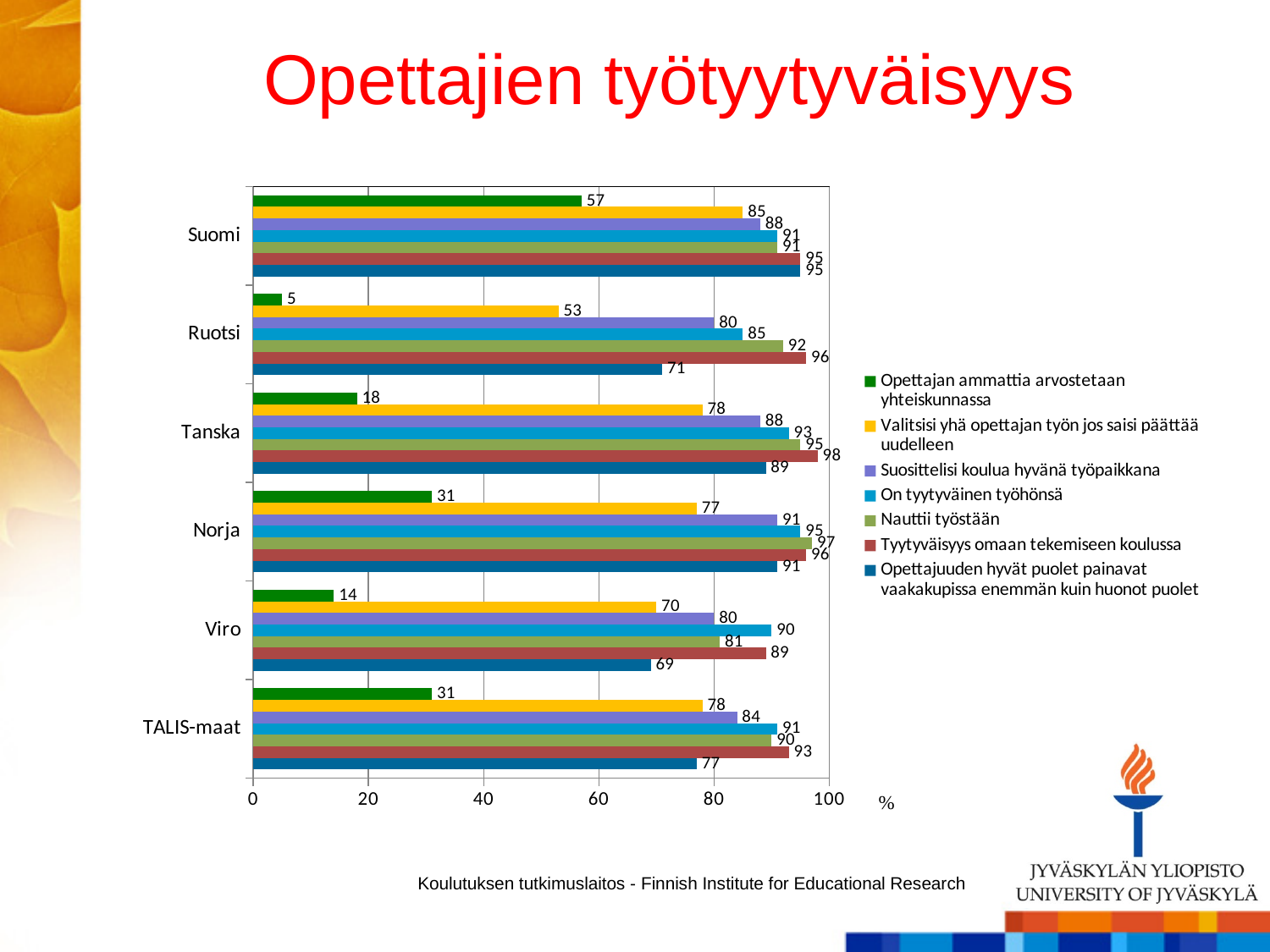
What is the difference between Suomi and Ruotsi in the series "Opettajan ammattia arvostetaan yhteiskunnassa"? 52 How many countries or groups are shown on the chart? 6 What is the value for Suomi in the series "Opettajan ammattia arvostetaan yhteiskunnassa"? 57 What is the value for Ruotsi in the series "Valitsisi yhä opettajan työn jos saisi päättää uudelleen"? 53 What kind of chart is shown on the slide? Bar chart What is the value for Viro in the series "On tyytyväinen työhönsä"? 90 How many series does the legend list? 7 What is the title of the slide? Opettajien työtyytyväisyys Which category has the lowest value in the series "Opettajan ammattia arvostetaan yhteiskunnassa"? Ruotsi Which is larger for Tanska: "Tyytyväisyys omaan tekemiseen koulussa" or "Opettajuuden hyvät puolet painavat vaakakupissa enemmän kuin huonot puolet"? Tyytyväisyys omaan tekemiseen koulussa Which country has the highest value in the series "Opettajan ammattia arvostetaan yhteiskunnassa"? Suomi What is the value for TALIS-maat in the series "Opettajuuden hyvät puolet painavat vaakakupissa enemmän kuin huonot puolet"? 77